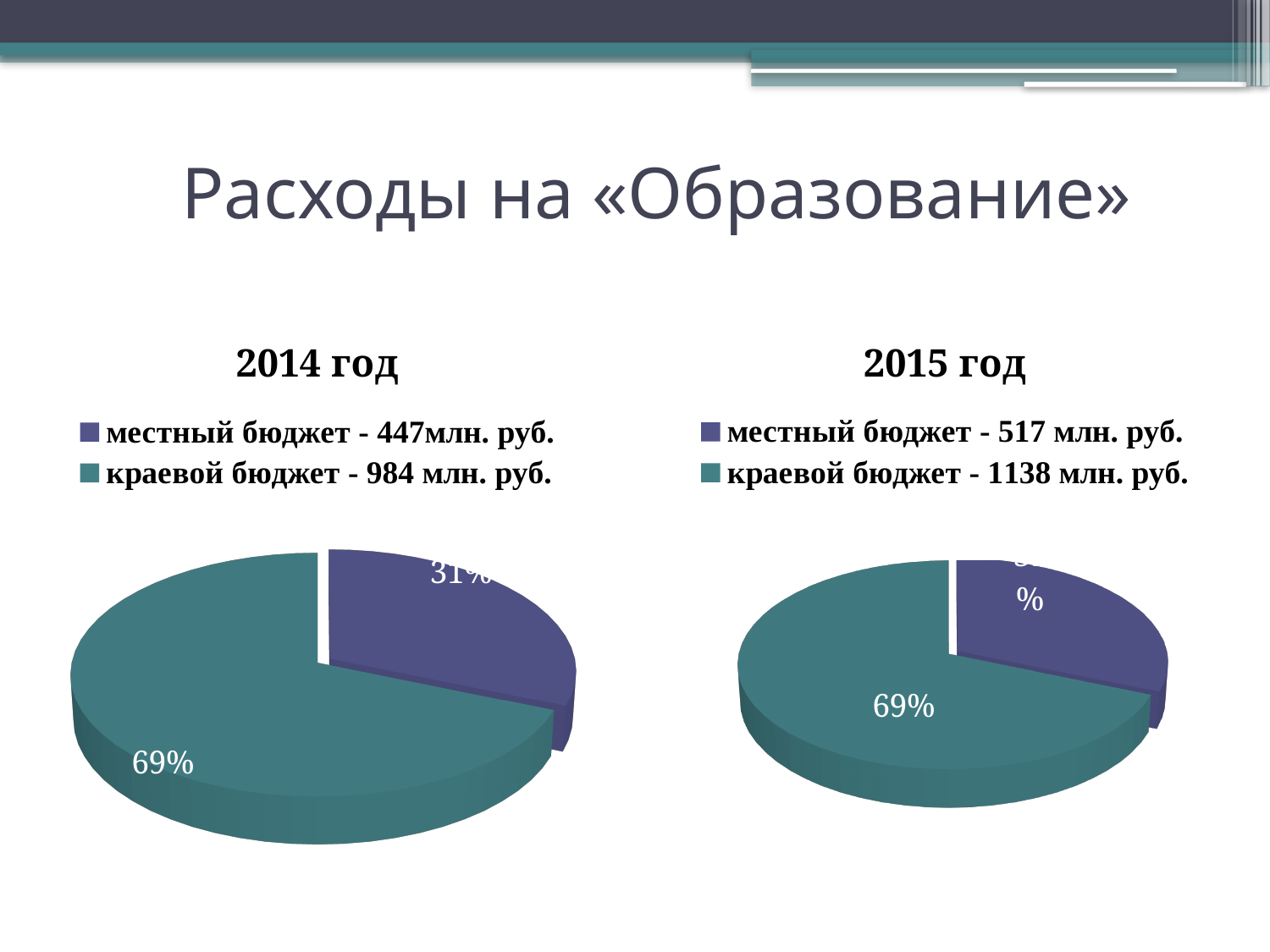
In the "2014 год" chart, what share of the pie does краевой бюджет take? 69% In the "2015 год" chart, which category is the largest? краевой бюджет What kind of chart is the "2014 год" chart? pie chart In the "2014 год" chart, what is the difference between краевой бюджет and местный бюджет in млн. руб.? 537 In the "2015 год" chart, what is the difference between краевой бюджет and местный бюджет in млн. руб.? 621 In the "2015 год" chart, what share of the pie does краевой бюджет take? 69% In the "2014 год" chart, what value does the legend give for местный бюджет? 447млн. руб. In the "2015 год" chart, what value does the legend give for краевой бюджет? 1138 млн. руб. In the "2014 год" chart, which category is the smallest? местный бюджет How many slices does the "2015 год" pie chart have? 2 Which colour represents краевой бюджет in the "2014 год" chart? teal (green) How many entries does the legend of the "2014 год" chart list? 2